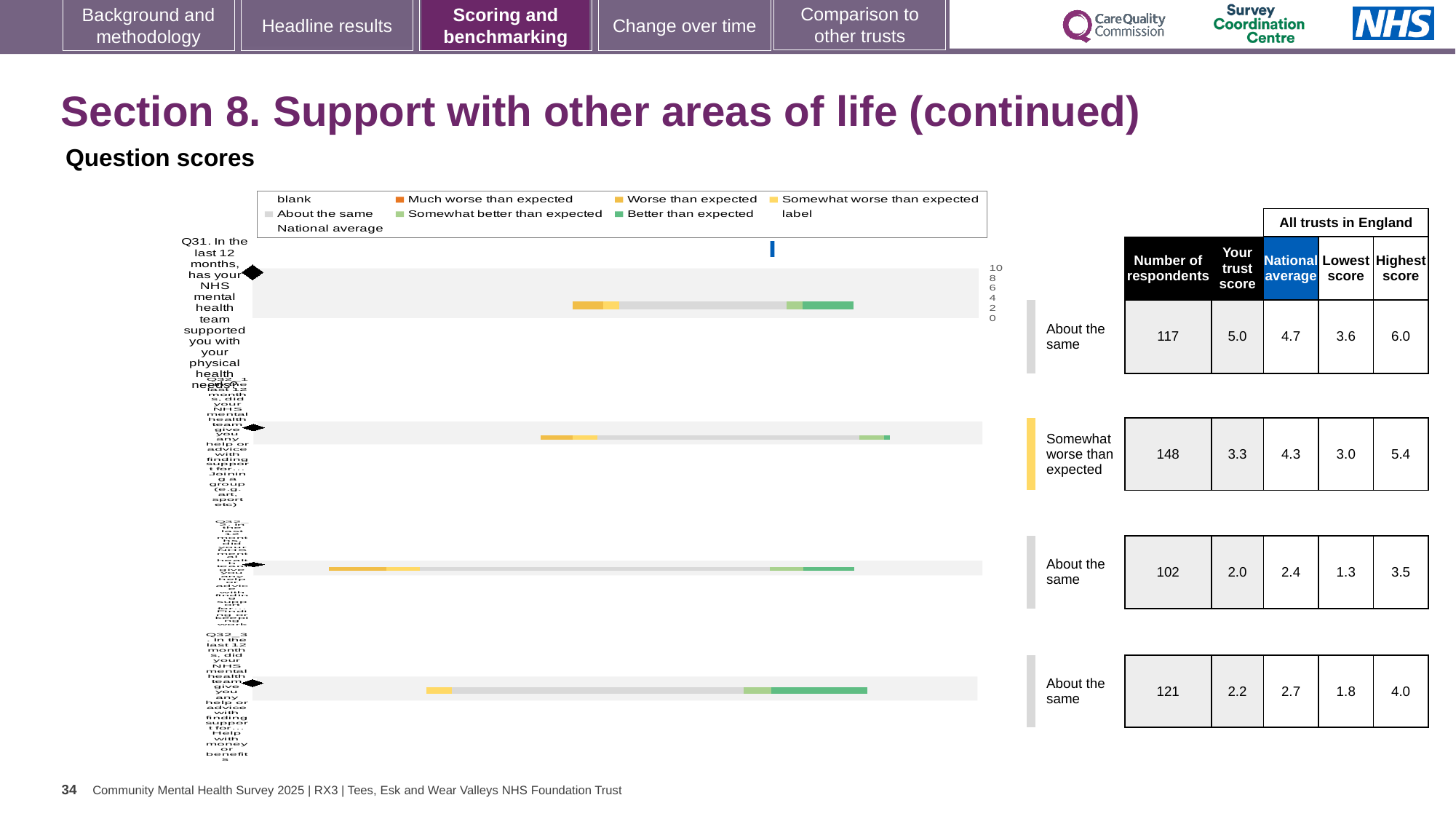
In the chart legend, what colour represents 'Much worse than expected'? orange In the table next to the chart, what is the highest score for the row labelled 'Somewhat worse than expected'? 5.4 In the table next to the chart, which is larger for Q31 (the first row): the trust score or the national average? trust score In the chart legend, what colour represents 'Better than expected'? green In the table next to the chart, what is 'Your trust score' for Q31 (the first row)? 5.0 In the table next to the chart, what is the difference between the trust score and the national average for Q31 (the first row)? 0.3 In the table next to the chart, what is the number of respondents for Q31 (the first row, 'About the same')? 117 How many question bars are plotted in the chart? 4 In the table next to the chart, what is the national average for Q31 (the first row)? 4.7 In the table next to the chart, which row has the highest number of respondents? Somewhat worse than expected (148) What kind of chart is shown on the slide? bar chart How many entries does the chart legend list? 9